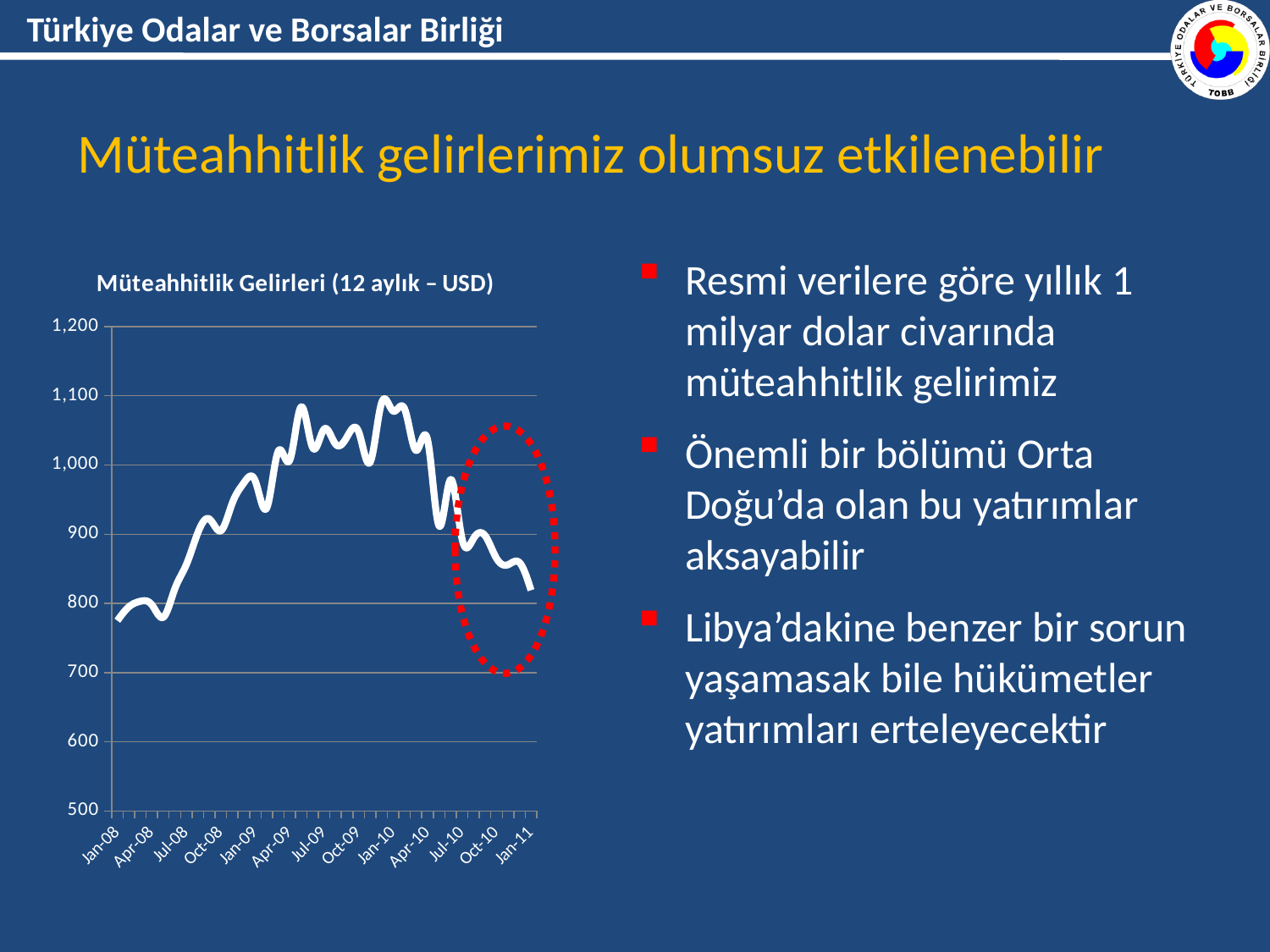
Do the values rise or fall between Jan-10 and Jan-11? fall What is the highest value shown on the y axis of the chart? 1,200 Is the value for Jan-09 greater or less than 900? greater Is the value for Jan-11 greater or less than 900? less Is the value for Jul-09 greater or less than 1,000? greater What is the title of the chart on the slide? Müteahhitlik Gelirleri (12 aylık – USD) How many date labels are shown along the x axis of the chart? 13 Which is larger, the value for Jan-10 or the value for Jan-11? Jan-10 What kind of chart is shown on the slide? line chart